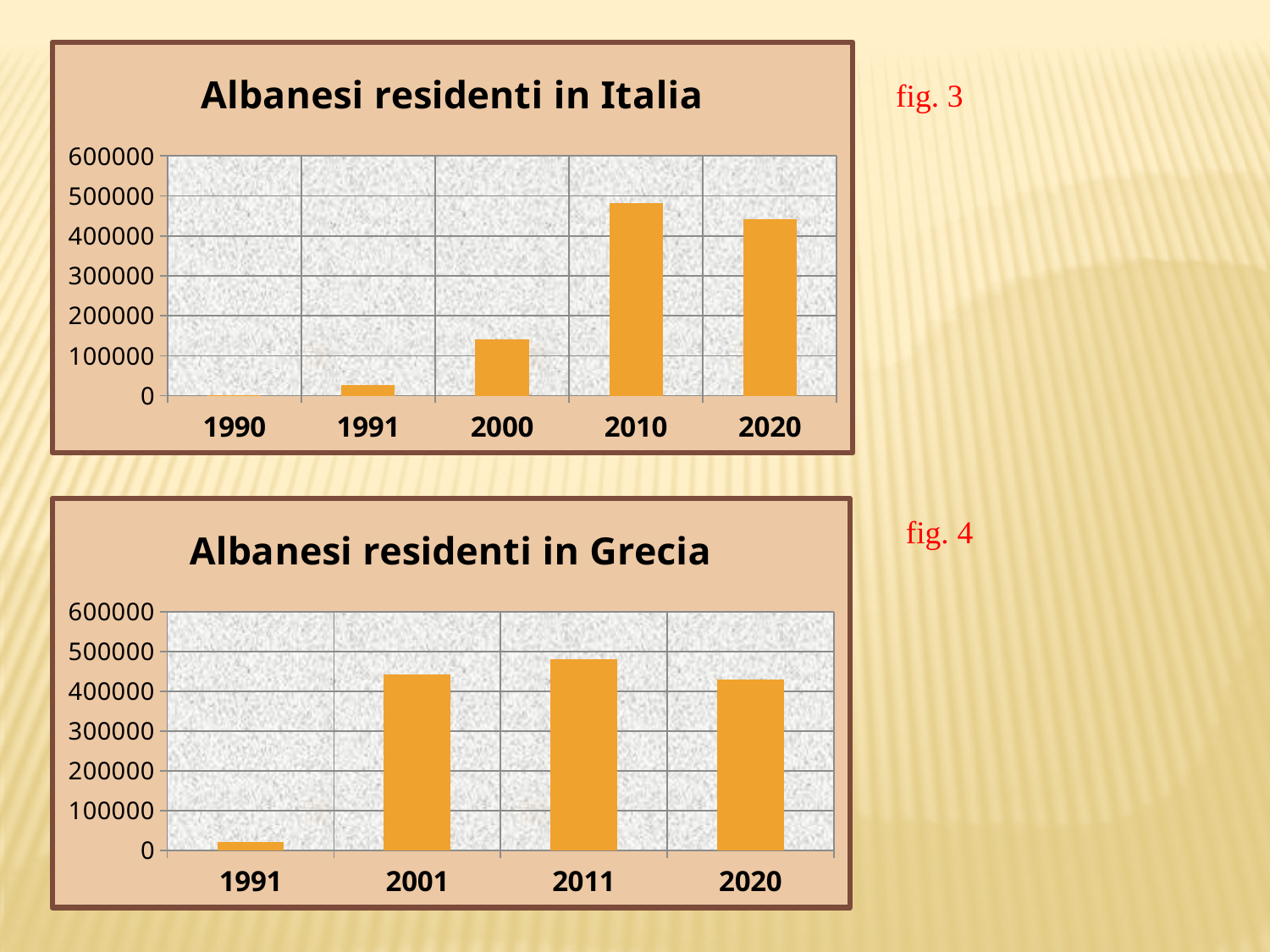
In the chart "Albanesi residenti in Italia", which year has the lowest value? 1990 In the chart "Albanesi residenti in Italia", which is larger, the value for 2000 or the value for 2020? 2020 What kind of chart is "Albanesi residenti in Italia"? bar chart In the chart "Albanesi residenti in Grecia", is the value for 2011 greater or less than 400000? greater In the chart "Albanesi residenti in Italia", is the value for 2010 greater or less than 400000? greater How many years are shown on the x axis of the chart "Albanesi residenti in Grecia"? 4 In the chart "Albanesi residenti in Italia", is the value for 2000 greater or less than 200000? less In the chart "Albanesi residenti in Grecia", which year has the highest value? 2011 In the chart "Albanesi residenti in Italia", which year has the highest value? 2010 In the chart "Albanesi residenti in Grecia", which year has the lowest value? 1991 How many years are shown on the x axis of the chart "Albanesi residenti in Italia"? 5